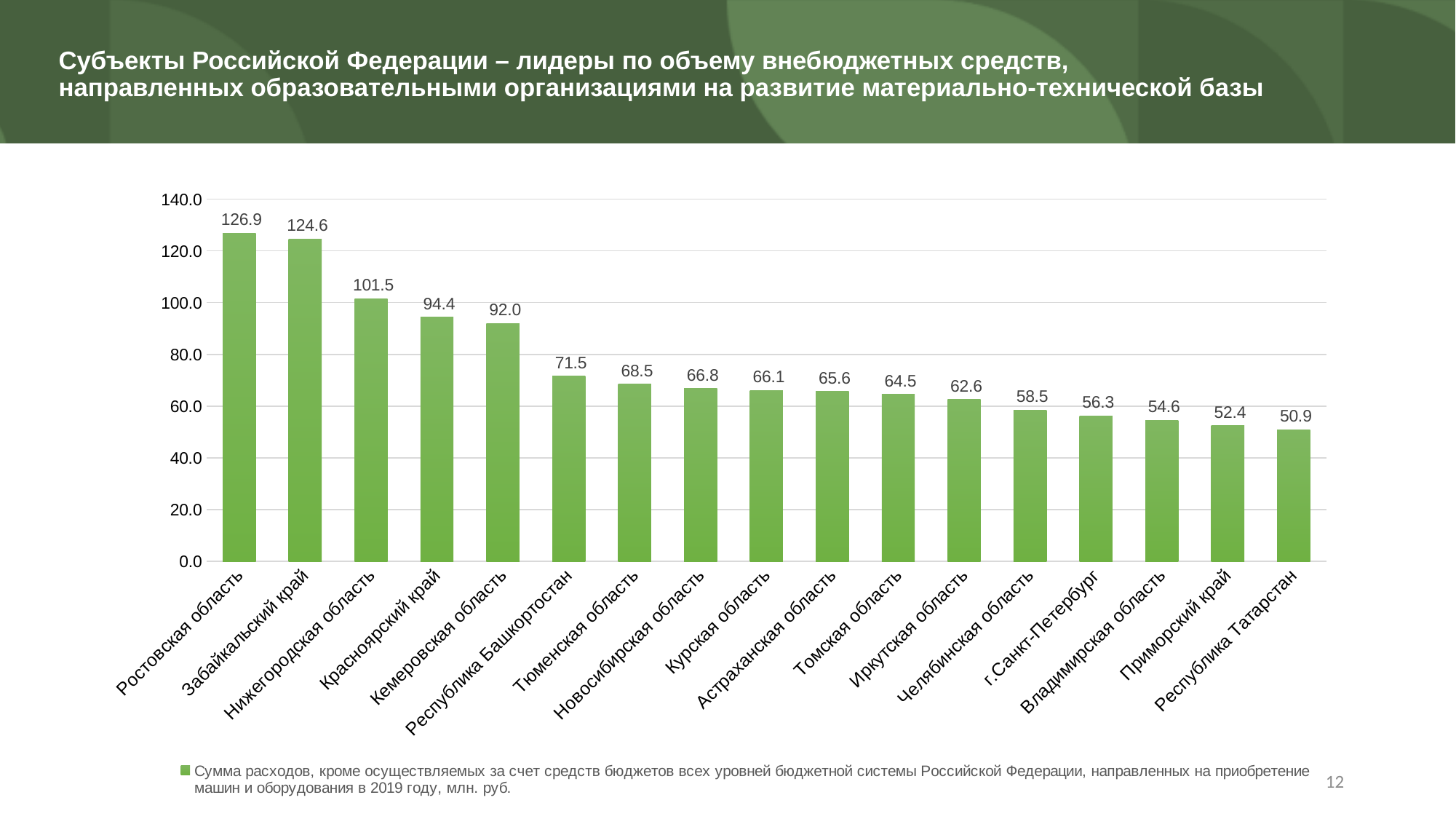
Do the values rise or fall from left to right along the x axis? fall What is the difference between the values for Ростовская область and Забайкальский край? 2.3 What kind of chart is shown on the slide? bar chart What is the value for Республика Башкортостан? 71.5 Is the value for Приморский край greater or less than 60.0? less Which region has the highest value? Ростовская область Which region has the lowest value? Республика Татарстан What is the value for г.Санкт-Петербург? 56.3 How many regions are shown in the chart? 17 Which is larger, the value for Кемеровская область or the value for Тюменская область? Кемеровская область What is the value for Ростовская область? 126.9 What is the difference between the values for Нижегородская область and Красноярский край? 7.1